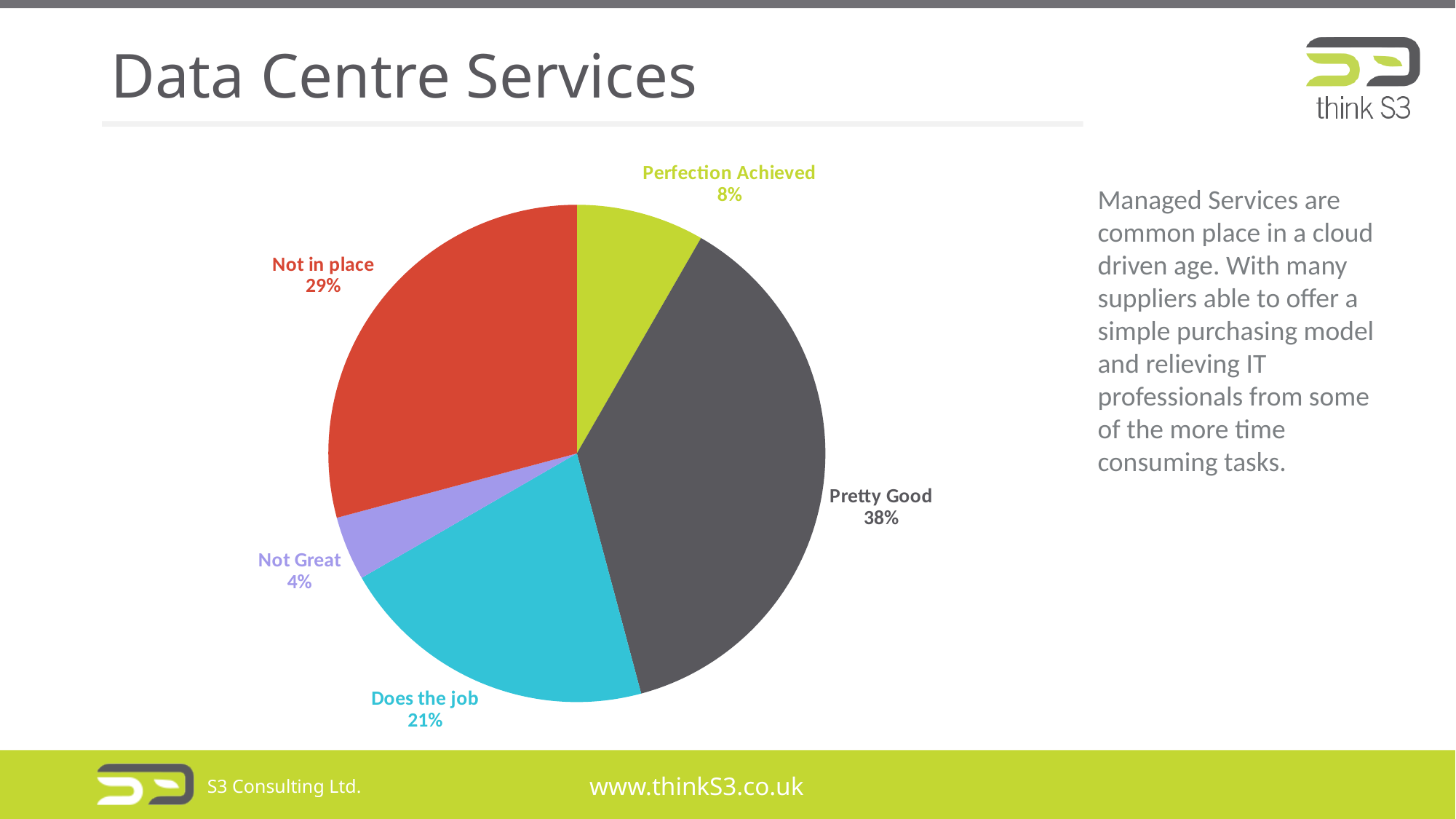
How many categories are shown in the pie chart? 5 Which category has the largest share of the pie? Pretty Good What percentage is shown for Not in place? 29% What percentage is shown for Not Great? 4% What percentage is shown for Pretty Good? 38% Which is larger, Does the job or Perfection Achieved? Does the job What kind of chart is shown on the slide? Pie chart What percentage is shown for Does the job? 21% Which category has the smallest share of the pie? Not Great What is the difference in percentage points between Pretty Good and Not in place? 9 What percentage is shown for Perfection Achieved? 8% What colour is the Not in place slice? Red